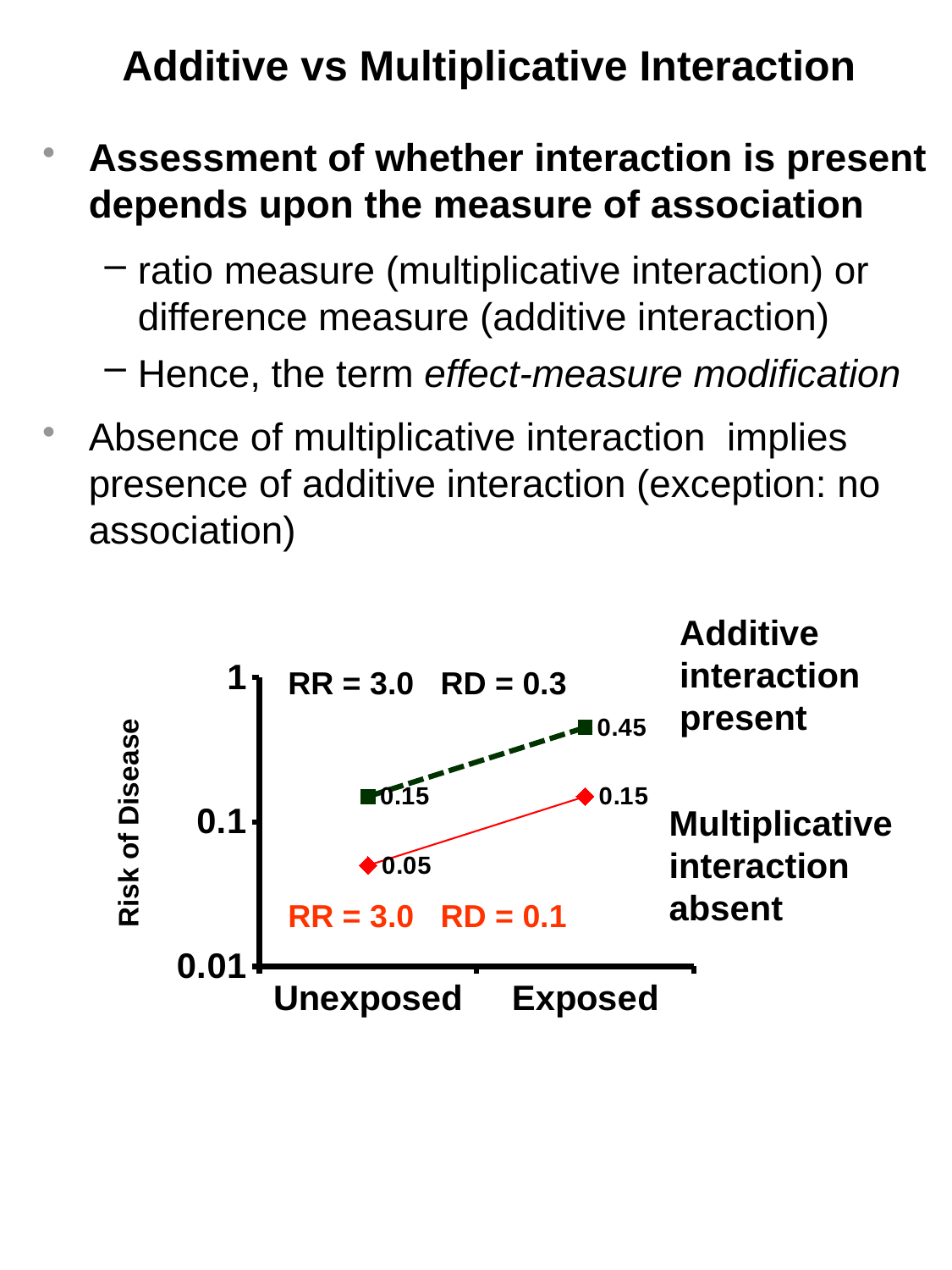
Which line has the higher value at Exposed, the dashed green line or the solid red line? the dashed green line What is the value of the solid red line at Exposed? 0.15 Do the values rise or fall from Unexposed to Exposed on the solid red line? rise What is the difference between the Exposed and Unexposed values on the solid red line? 0.1 What is the label of the y axis? Risk of Disease What is the value of the solid red line at Unexposed? 0.05 What is the value of the dashed green line at Unexposed? 0.15 Is the Unexposed value on the solid red line greater or less than 0.1? less What is the value of the dashed green line at Exposed? 0.45 What type of chart is shown on the slide? line chart What is the difference between the Exposed and Unexposed values on the dashed green line? 0.3 How many categories are shown on the x axis? 2